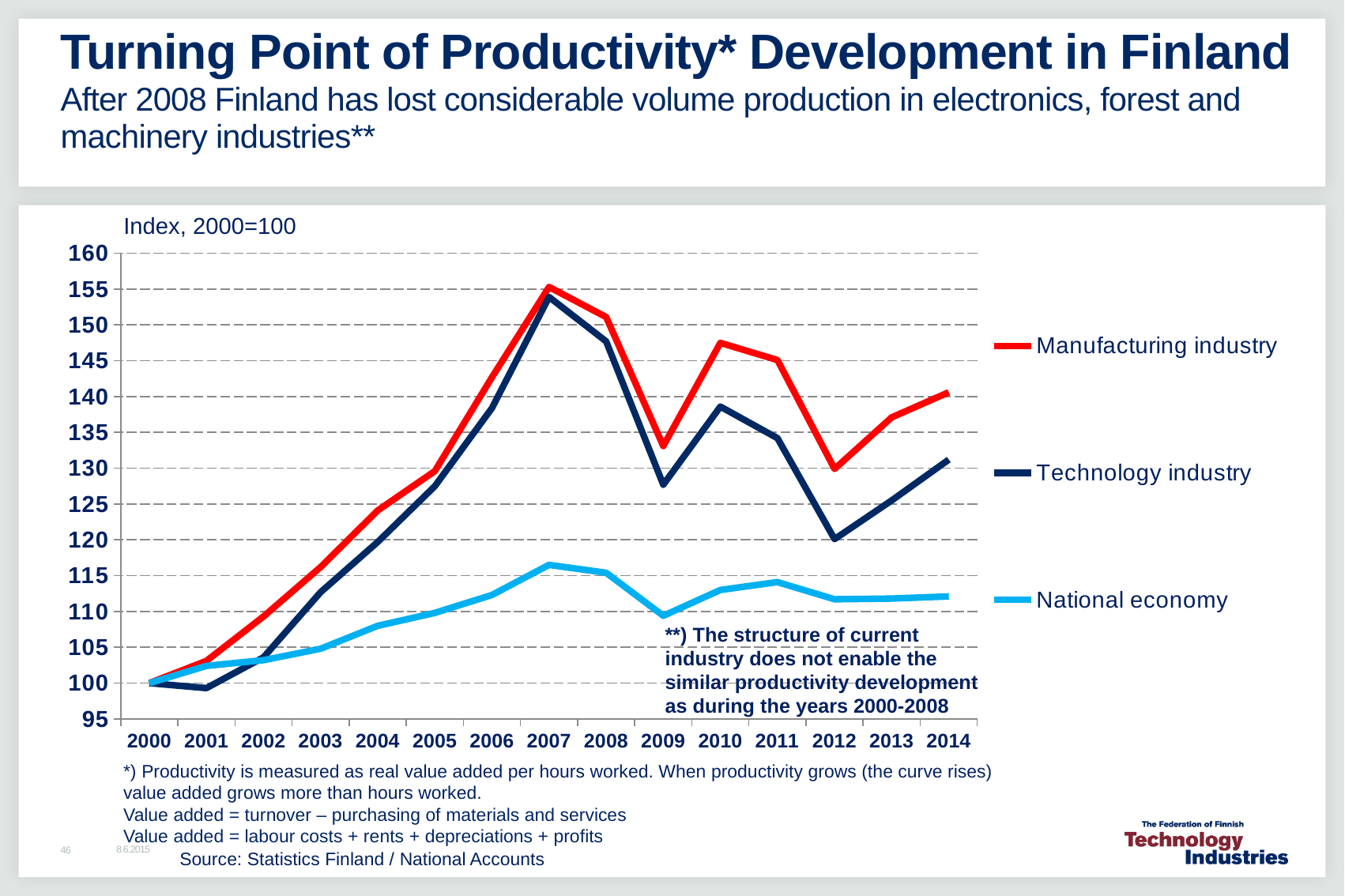
Which series has the highest value in 2014? Manufacturing industry Is the value for National economy in 2014 greater or less than 110? greater In which year does the Manufacturing industry line reach its highest value? 2007 Is the value for Technology industry in 2010 greater or less than 140? less What kind of chart is shown on the slide? line chart What is the index value for Manufacturing industry in 2000? 100 Does the Technology industry line rise or fall from 2011 to 2012? fall In 2010, which is larger: Manufacturing industry or Technology industry? Manufacturing industry How many years are plotted along the x axis? 15 Is the value for Manufacturing industry in 2007 greater or less than 150? greater How many series does the legend list? 3 Which series has the lowest value in 2007? National economy